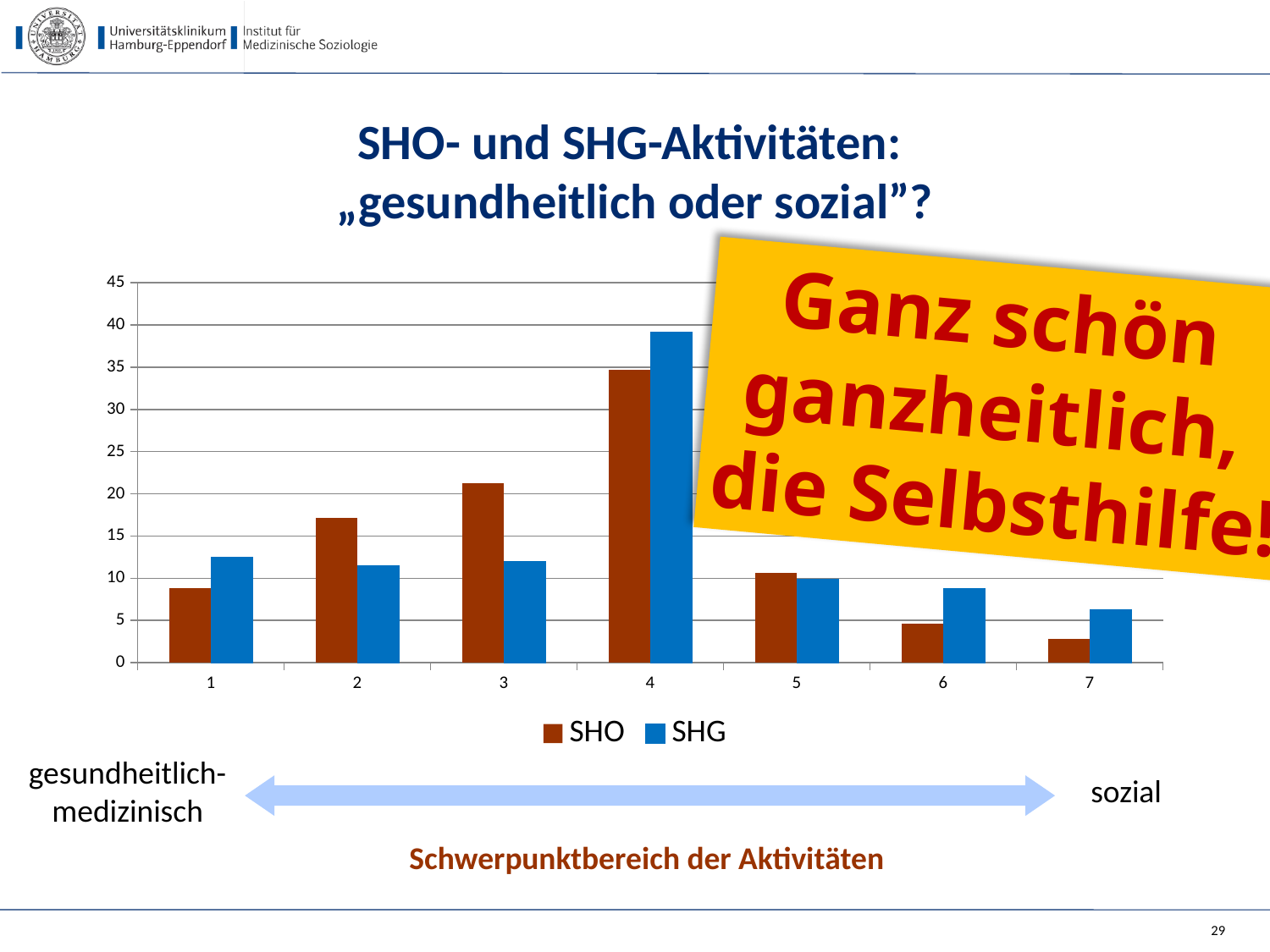
For which category is the SHO value highest? 4 How many series does the legend list? 2 How many categories are shown on the x axis? 7 Is the SHO value for category 7 greater or less than 5? less Is the SHO value for category 2 greater or less than 15? greater Is the SHG value for category 4 greater or less than 35? greater For which category is the SHO value lowest? 7 For which category is the SHG value highest? 4 What are the two series named in the legend? SHO and SHG What kind of chart is shown on the slide? bar chart For category 3, which series has the larger value, SHO or SHG? SHO